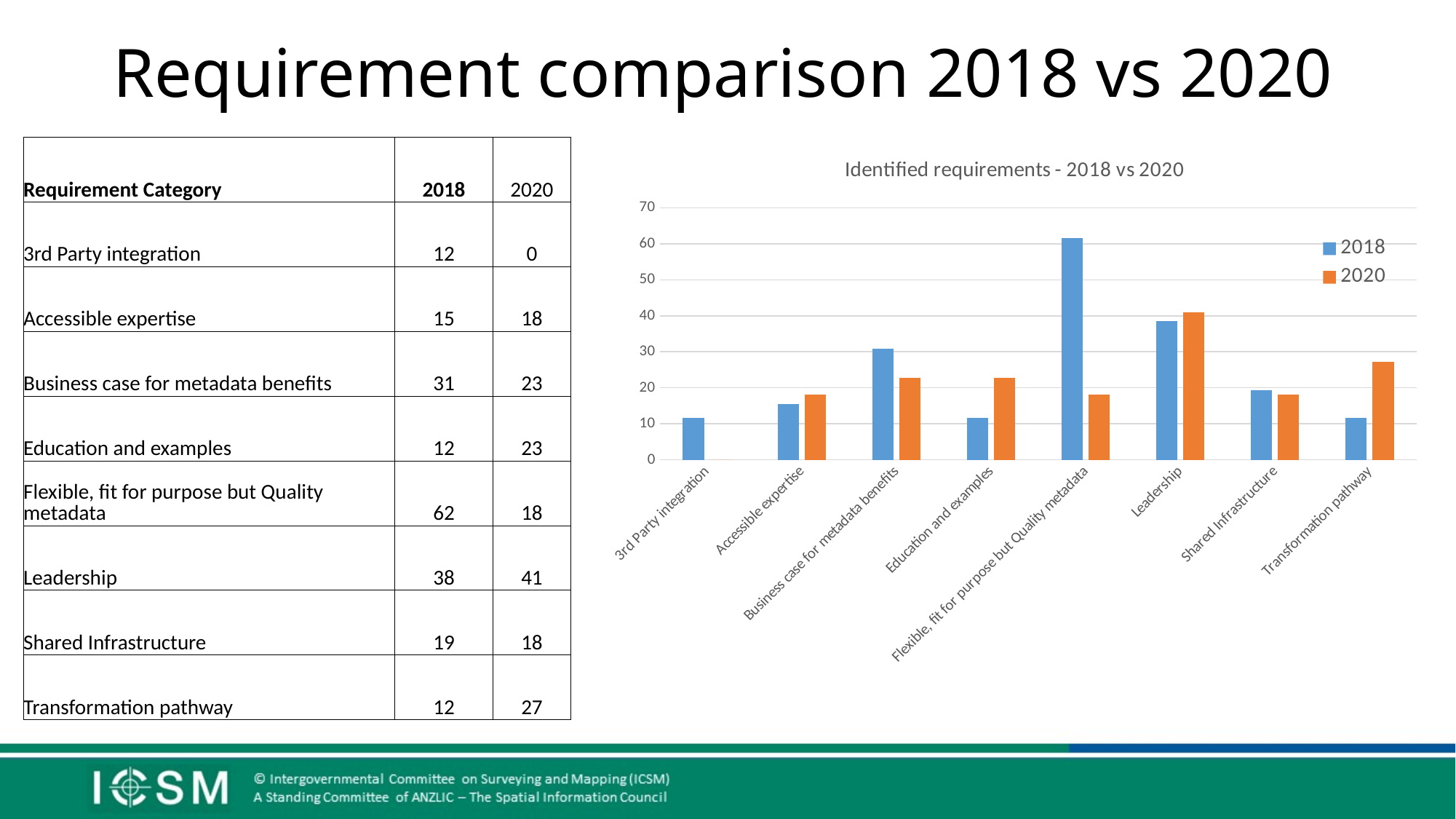
Is the 2018 value for Flexible, fit for purpose but Quality metadata greater or less than 50? greater How many series does the chart legend list? 2 For Business case for metadata benefits, which is larger: the 2018 value or the 2020 value? 2018 Is the 2020 value for Transformation pathway greater or less than 20? greater For Leadership, which is larger: the 2018 value or the 2020 value? 2020 Which category has the highest 2018 value on the chart? Flexible, fit for purpose but Quality metadata What kind of chart is shown on the slide? bar chart Which category has the lowest 2020 value on the chart? 3rd Party integration How many requirement categories are plotted on the chart? 8 Which category has the highest 2020 value on the chart? Leadership What is the 2020 value for Leadership? 41 What is the title of the chart? Identified requirements - 2018 vs 2020